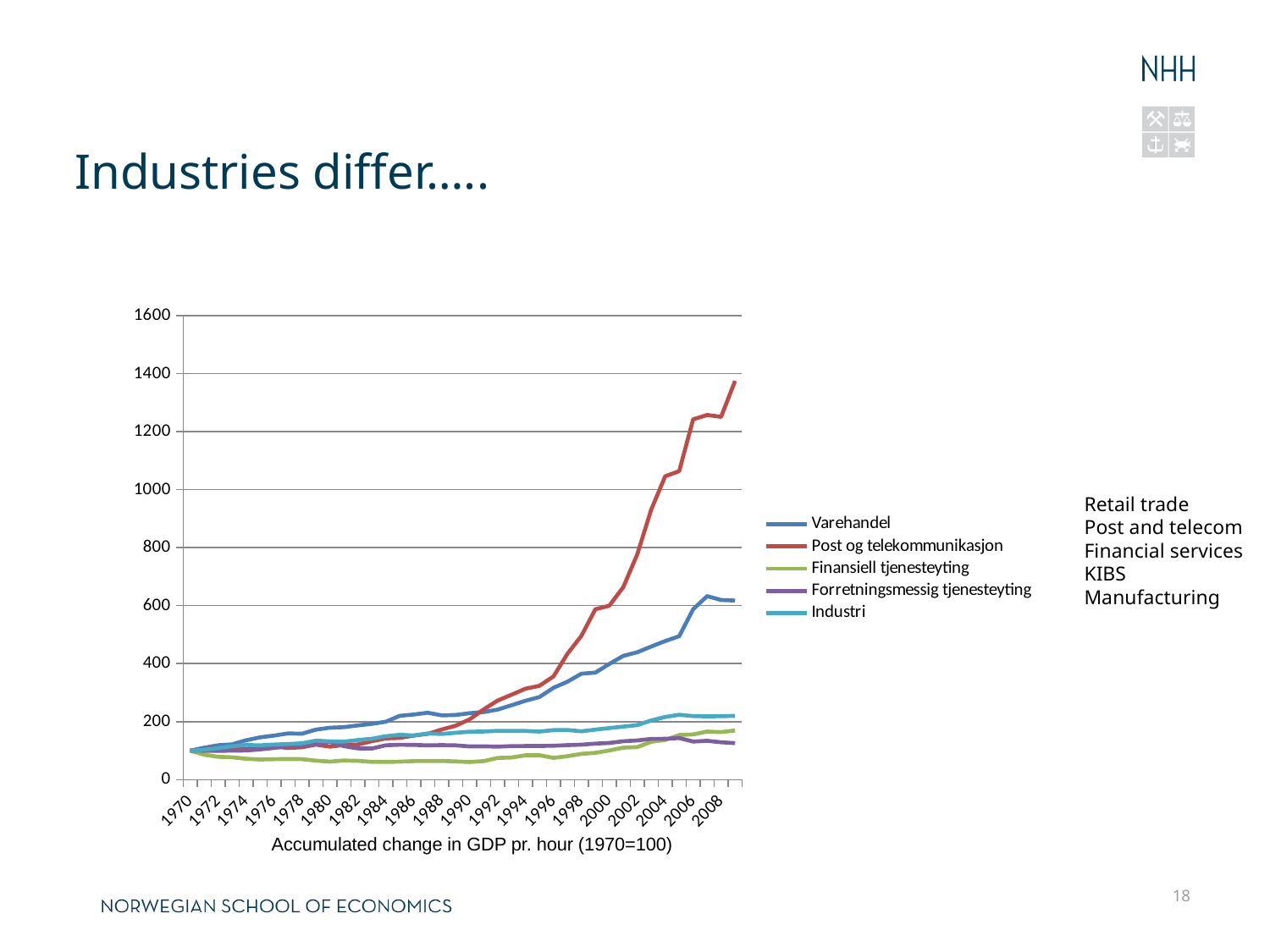
In 2008, which is larger: Varehandel or Industri? Varehandel How many series does the chart's legend list? 5 Which series has the highest value in 2008? Post og telekommunikasjon Is the value for Post og telekommunikasjon in 2008 greater or less than 1200? greater Is the value for Varehandel in 2000 greater or less than 600? less What is the caption below the chart's x axis? Accumulated change in GDP pr. hour (1970=100) Which series has the lowest value in 1990? Finansiell tjenesteyting Does the Post og telekommunikasjon series rise or fall from 1970 to 2008? rise What kind of chart is shown on the slide? line chart Is the value for Post og telekommunikasjon in 2000 greater or less than 400? greater What colour is the Post og telekommunikasjon line in the legend? red